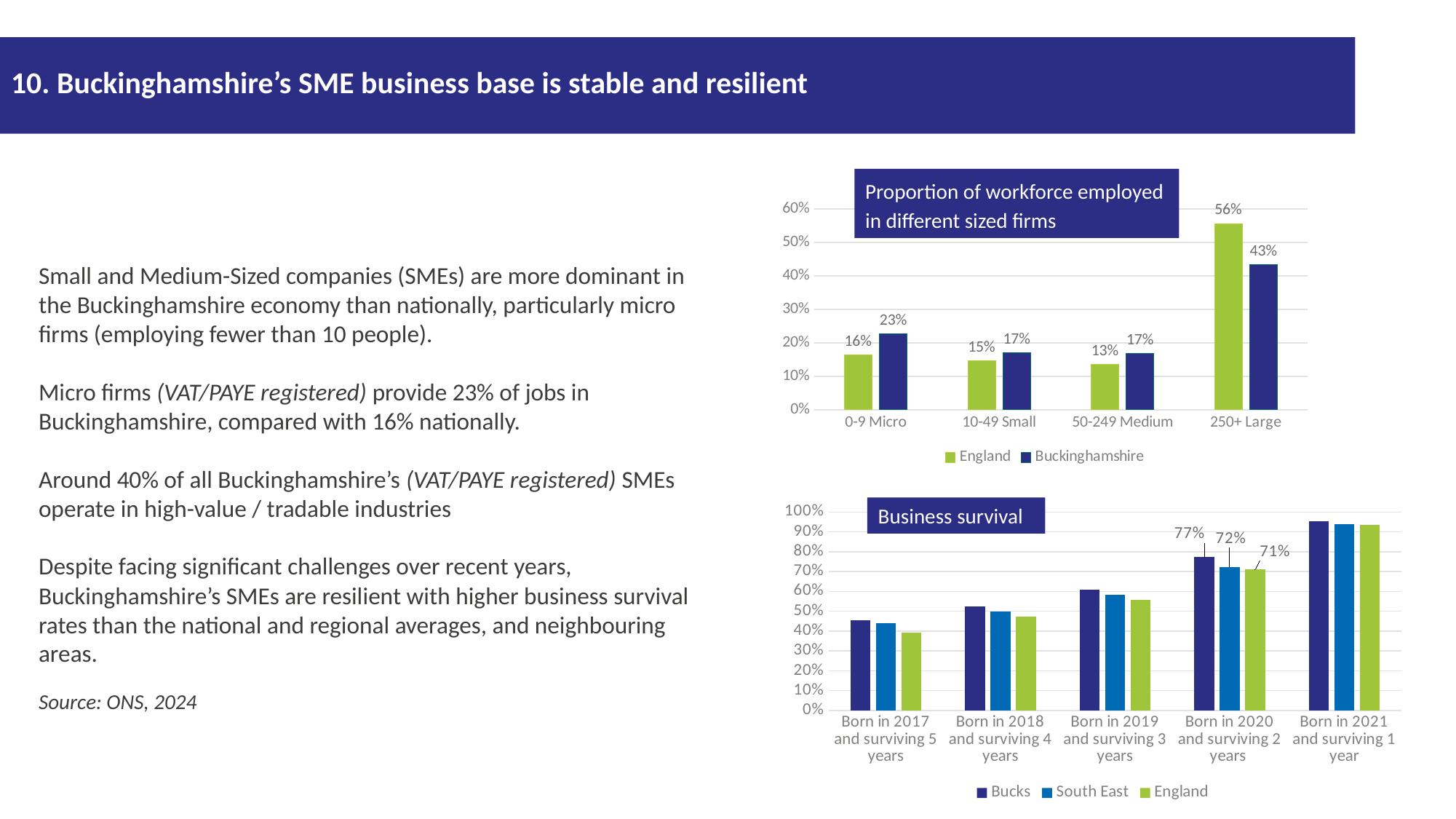
In the 'Proportion of workforce employed in different sized firms' chart, which firm size category has the lowest England value? 50-249 Medium In the 'Business survival' chart, what is the Bucks value for businesses born in 2020 and surviving 2 years? 77% In the 'Business survival' chart, what is the difference between the Bucks and England values for businesses born in 2020 and surviving 2 years? 6% In the 'Proportion of workforce employed in different sized firms' chart, what is the difference between the England and Buckinghamshire values for 250+ Large firms? 13% In the 'Proportion of workforce employed in different sized firms' chart, what is the Buckinghamshire value for 0-9 Micro firms? 23% In the 'Proportion of workforce employed in different sized firms' chart, what is the England value for 250+ Large firms? 56% What kind of chart is the 'Business survival' chart? Bar chart In the 'Proportion of workforce employed in different sized firms' chart, which firm size category has the highest England value? 250+ Large In the 'Proportion of workforce employed in different sized firms' chart, which is larger for 0-9 Micro firms, England or Buckinghamshire? Buckinghamshire How many firm size categories are shown in the 'Proportion of workforce employed in different sized firms' chart? 4 How many series does the legend of the 'Business survival' chart list? 3